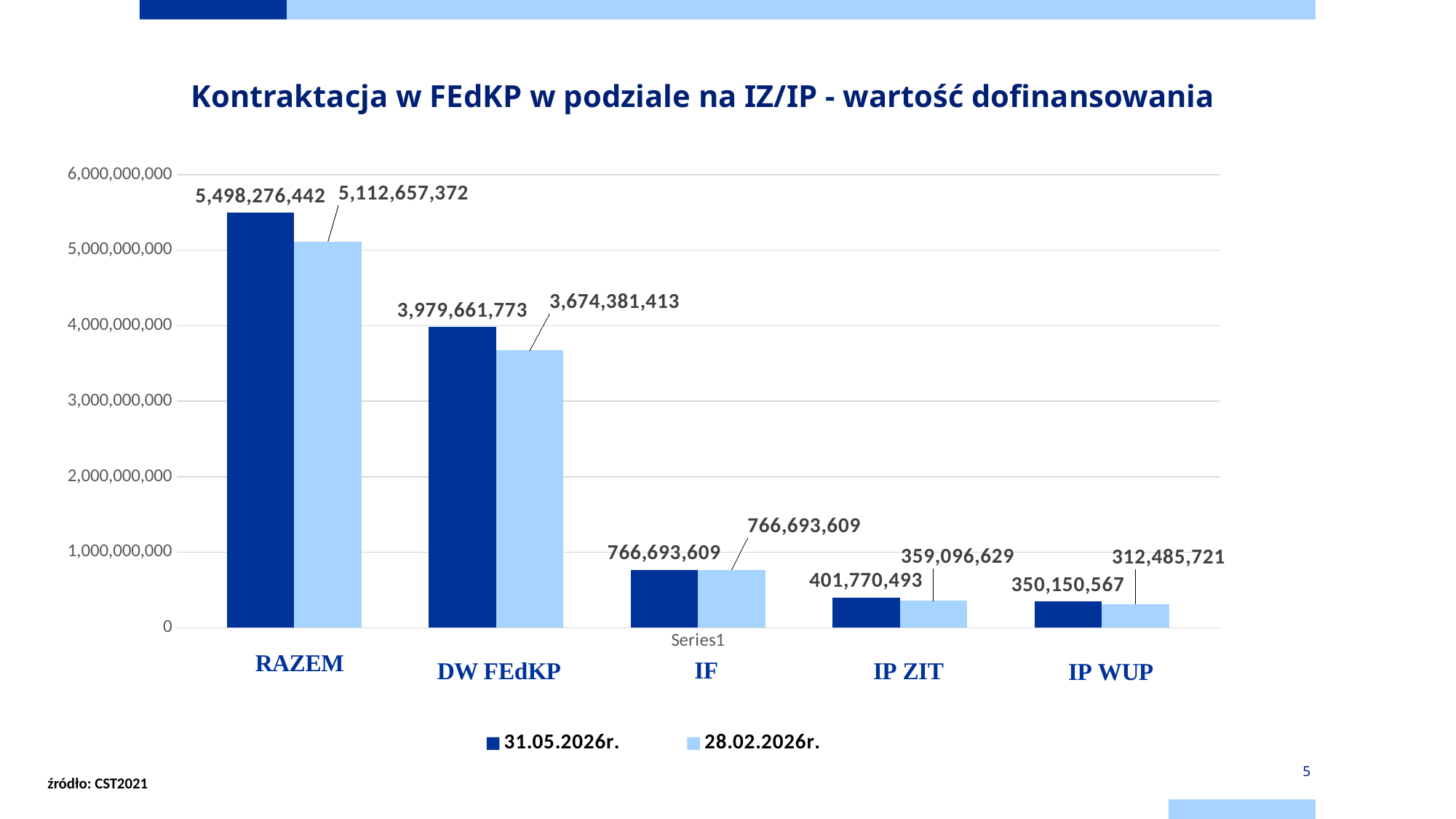
What is the difference between the 31.05.2026r. and 28.02.2026r. values for IP ZIT? 42,673,864 What is the value for DW FEdKP in the 31.05.2026r. series? 3,979,661,773 What is the difference between the 31.05.2026r. and 28.02.2026r. values for RAZEM? 385,619,070 How many categories are shown on the x axis? 5 What is the value for IP ZIT in the 28.02.2026r. series? 359,096,629 Which is larger for DW FEdKP: the 31.05.2026r. value or the 28.02.2026r. value? 31.05.2026r. How many series does the legend list? 2 Is the 31.05.2026r. value for IF greater or less than 1,000,000,000? less What type of chart is shown on the slide? bar chart Which category has the lowest value in the 31.05.2026r. series? IP WUP What is the value for IP WUP in the 31.05.2026r. series? 350,150,567 Which category has the highest value in the 28.02.2026r. series? RAZEM